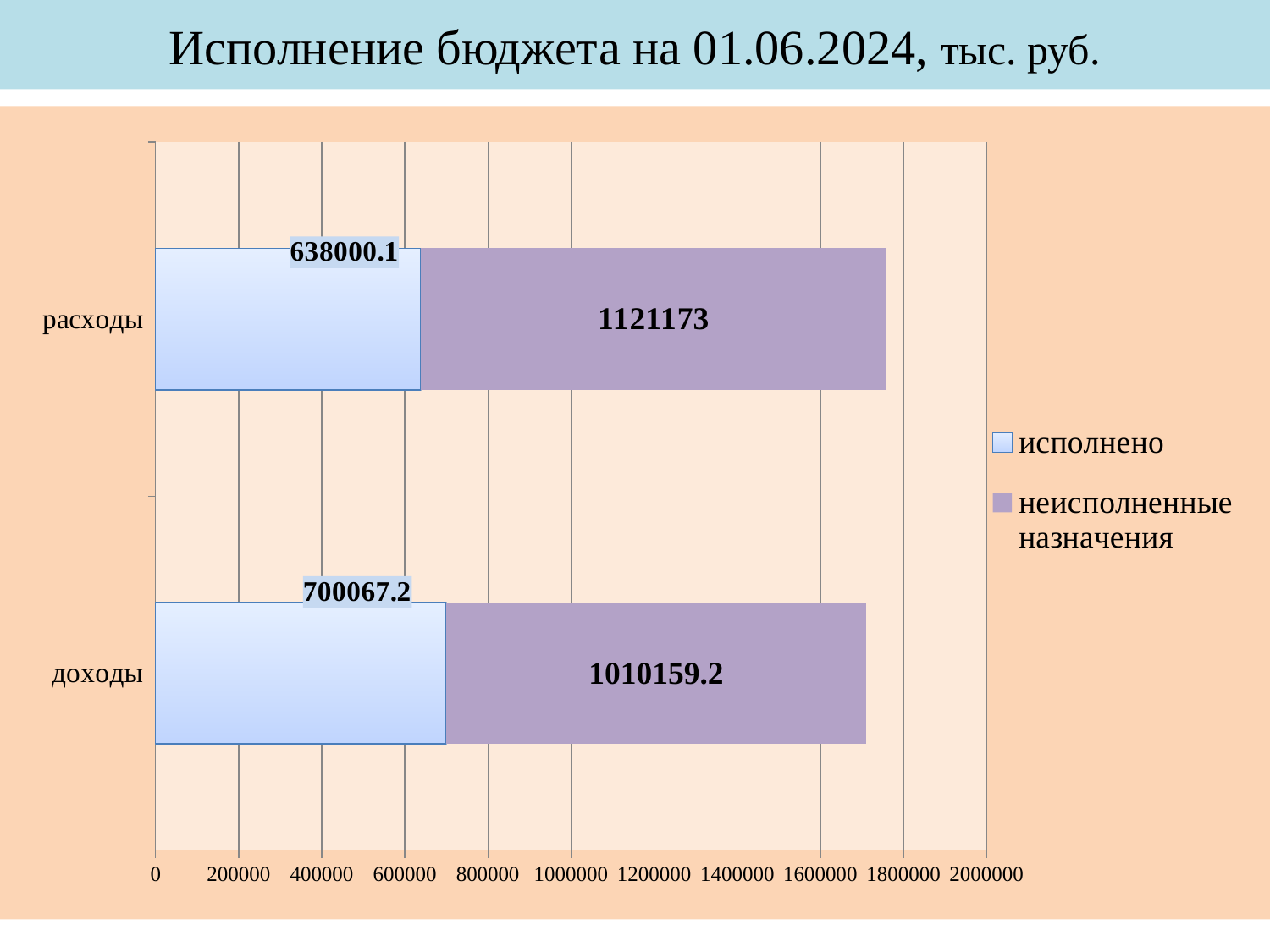
What is the value of неисполненные назначения for расходы? 1121173 What is the difference between the исполнено values for доходы and расходы? 62067.1 What is the total of the stacked bar for расходы? 1759173.1 What is the value of исполнено for расходы? 638000.1 What is the difference between the неисполненные назначения values for расходы and доходы? 111013.8 What kind of chart is shown on the slide? Stacked bar chart Which category has the higher неисполненные назначения value? расходы What is the total of the stacked bar for доходы? 1710226.4 What is the value of неисполненные назначения for доходы? 1010159.2 How many series does the legend list? 2 What is the value of исполнено for доходы? 700067.2 Which category has the higher исполнено value, расходы or доходы? доходы